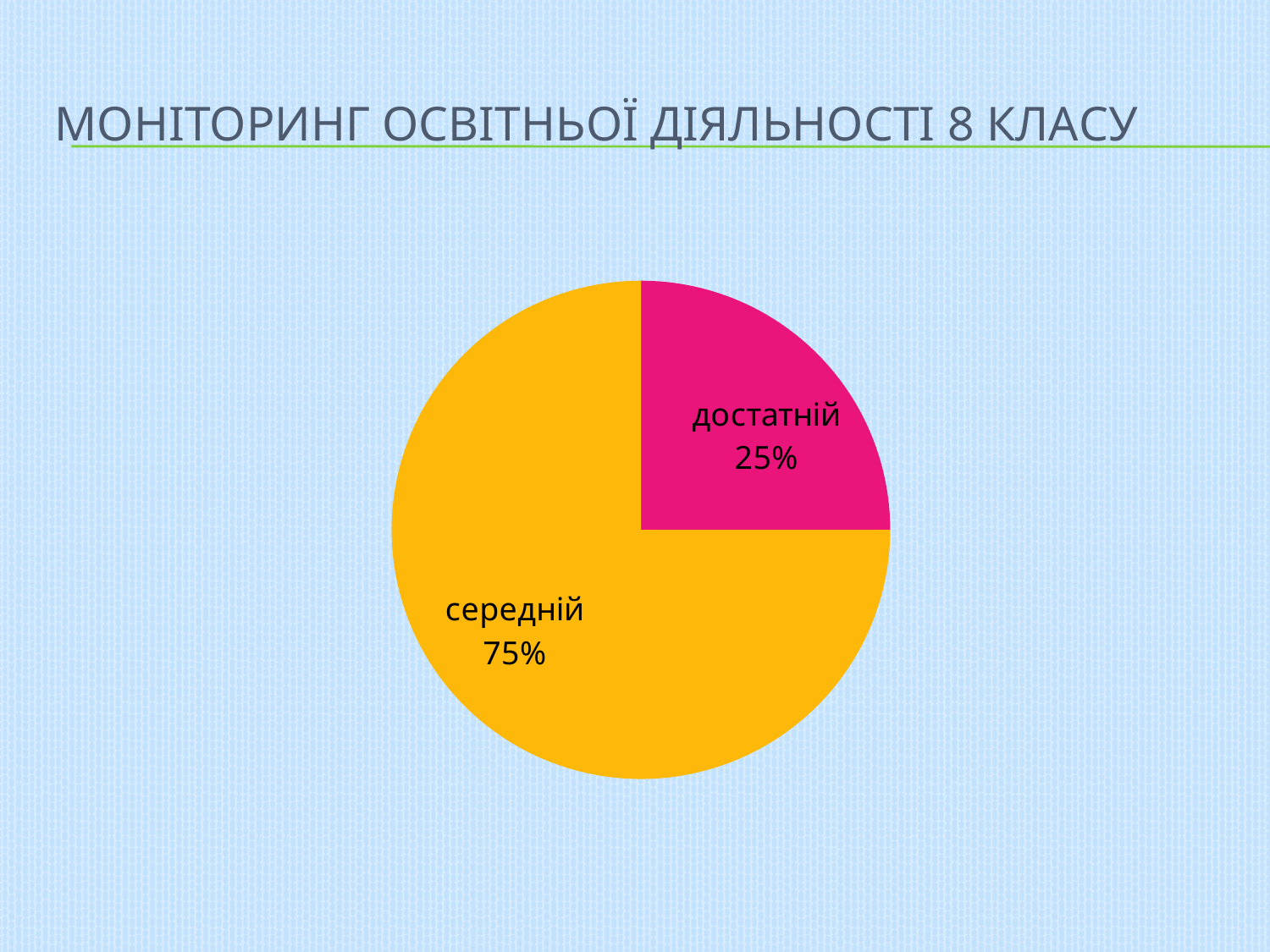
How many slices does the pie chart have? 2 What is the value for the "середній" slice? 75% Which is larger, the "середній" slice or the "достатній" slice? середній What is the difference between the "середній" and "достатній" slices? 50% What kind of chart is shown on the slide? pie chart What colour is the "достатній" slice? pink Which slice is the smallest? достатній What is the title of the slide containing the chart? МОНІТОРИНГ ОСВІТНЬОЇ ДІЯЛЬНОСТІ 8 КЛАСУ Which slice is the largest? середній What is the value for the "достатній" slice? 25% What share of the pie does the "достатній" slice take? 25%